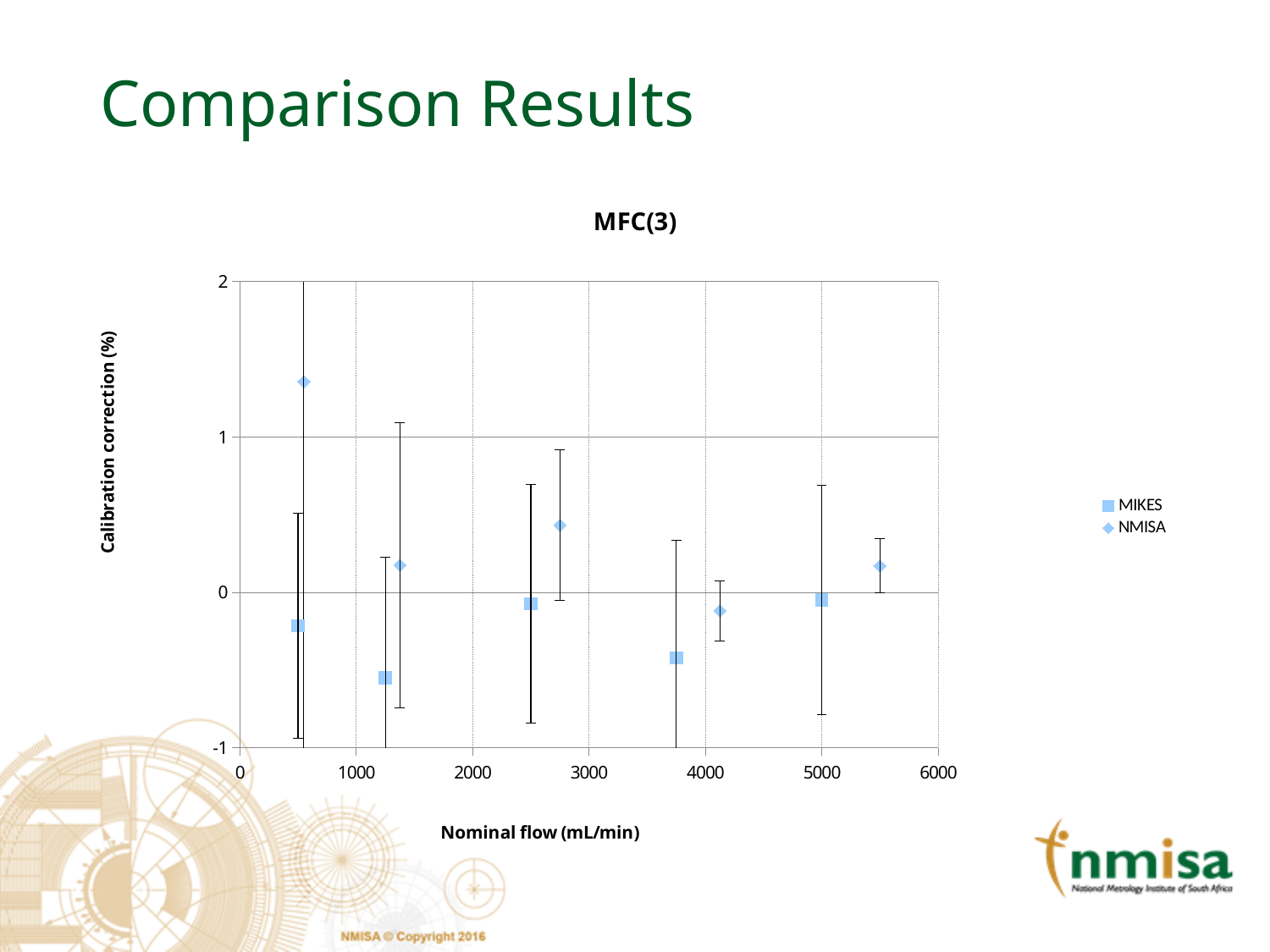
How many MIKES data points are plotted? 5 How many series does the legend list? 2 Is the NMISA value at the lowest nominal flow (leftmost NMISA point) greater or less than 1? greater What are the two series named in the legend? MIKES and NMISA Which MIKES point has the lowest calibration correction value? the second point from the left What kind of chart is shown on the slide? scatter chart Is the MIKES value at the second-lowest nominal flow (second MIKES point from the left) greater or less than 0? less Is the NMISA value at the highest nominal flow (rightmost NMISA point) greater or less than 0? greater How many NMISA data points are plotted? 5 Near a nominal flow of about 1300 mL/min, which series has the higher calibration correction, MIKES or NMISA? NMISA Which series contains the highest plotted calibration correction value? NMISA What is the title of the chart? MFC(3)